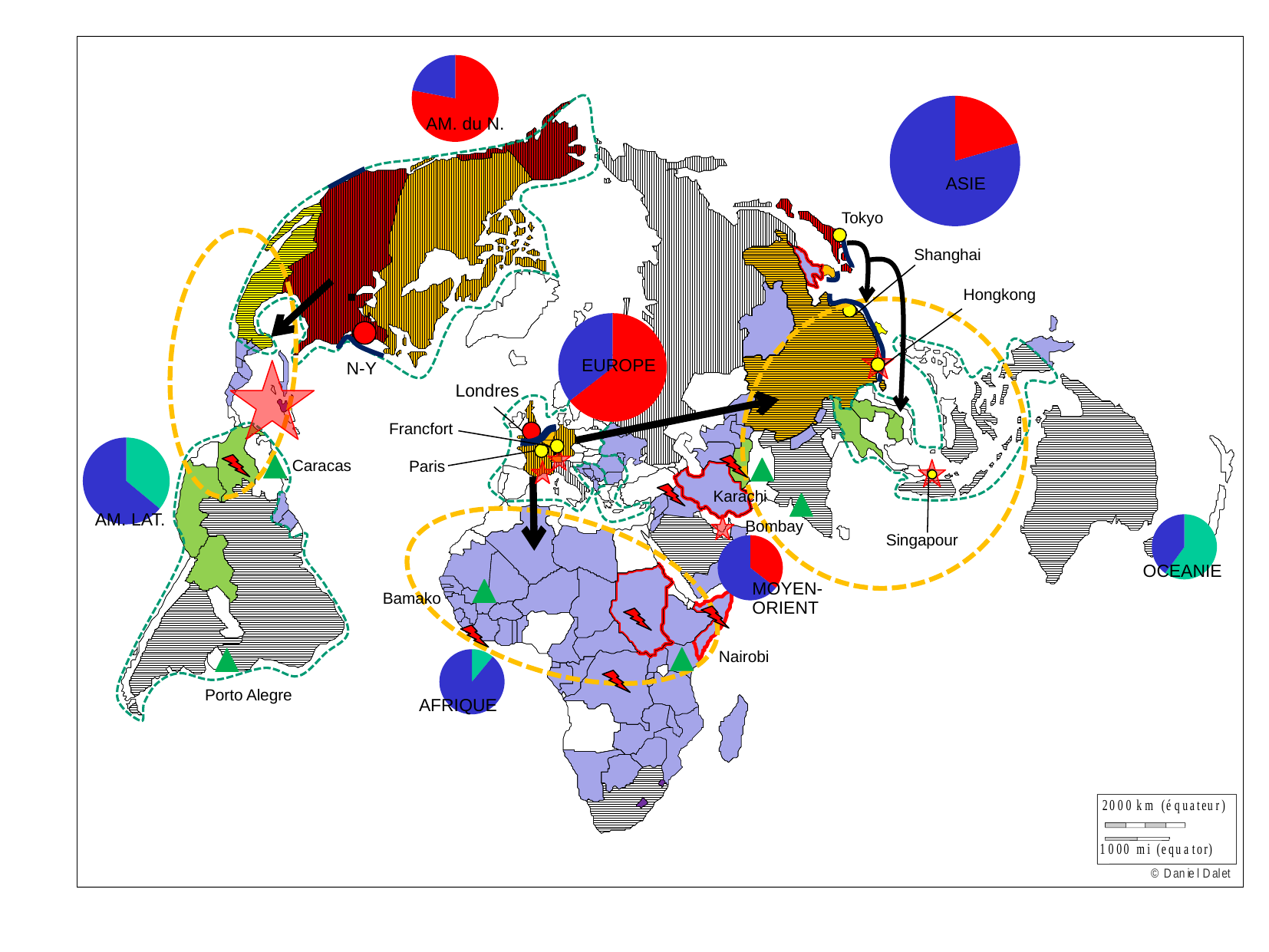
In the MOYEN-ORIENT pie chart, which slice is larger, the red one or the blue one? Blue What kind of chart is used for the regional figures (AM. du N., ASIE, EUROPE, etc.) on the slide? Pie chart In the EUROPE pie chart, which slice is larger, the red one or the blue one? Red How many pie charts are shown on the slide? 7 In the AFRIQUE pie chart, which slice is larger, the blue one or the teal one? Blue Among the pie charts with red and blue slices, which region's pie has the largest red share? AM. du N. How many slices does the ASIE pie chart have? 2 Which region's pie chart has the largest blue share? AFRIQUE What two colours are used in the OCEANIE pie chart? Blue and teal